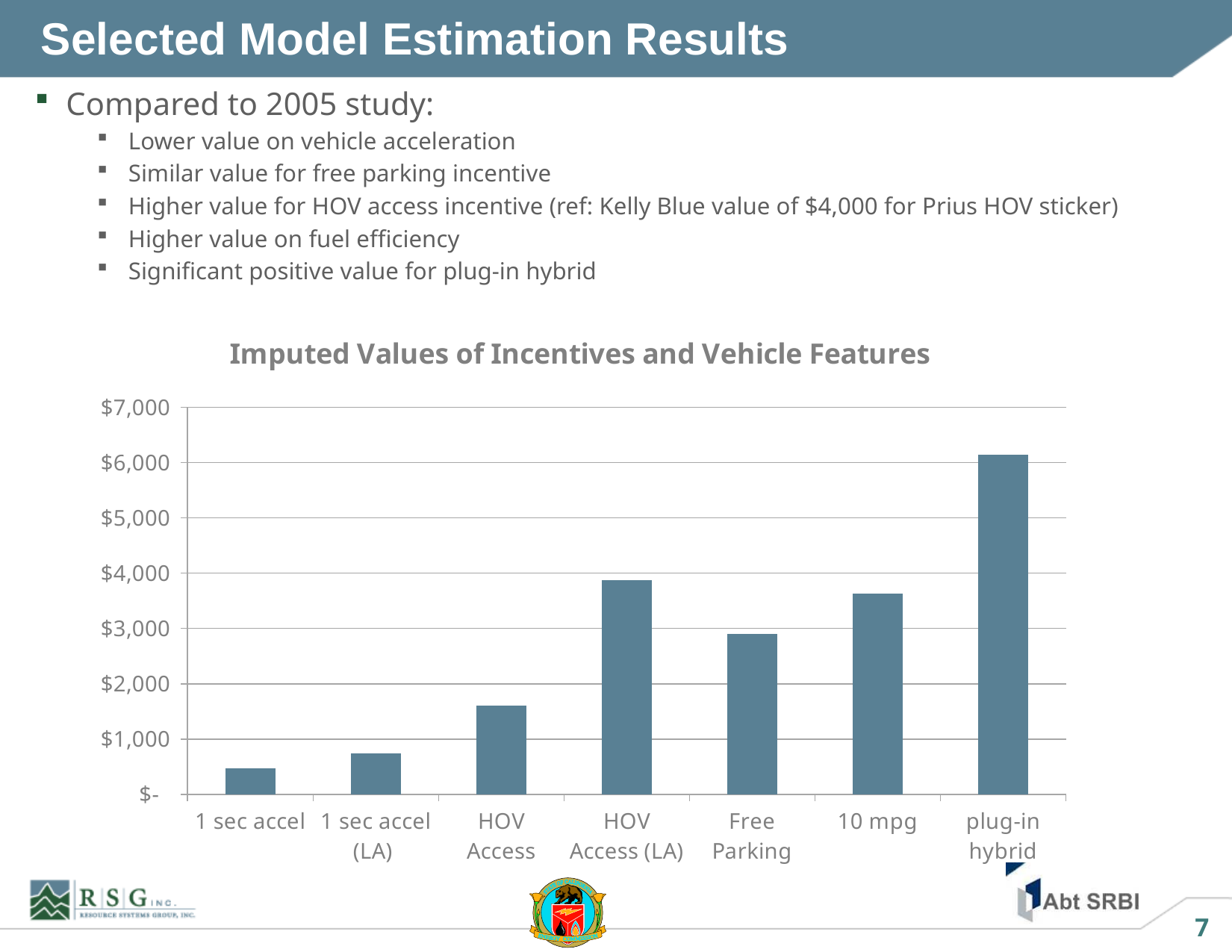
Which has a larger imputed value, HOV Access (LA) or Free Parking? HOV Access (LA) Which category has the highest imputed value? plug-in hybrid Is the value for HOV Access (LA) greater or less than $4,000? less Which has a larger imputed value, 1 sec accel or 1 sec accel (LA)? 1 sec accel (LA) Which category has the lowest imputed value? 1 sec accel How many categories are shown on the x axis of the chart? 7 Is the value for 1 sec accel greater or less than $1,000? less What is the title of the chart? Imputed Values of Incentives and Vehicle Features Is the value for plug-in hybrid greater or less than $5,000? greater What kind of chart is shown on the slide? bar chart